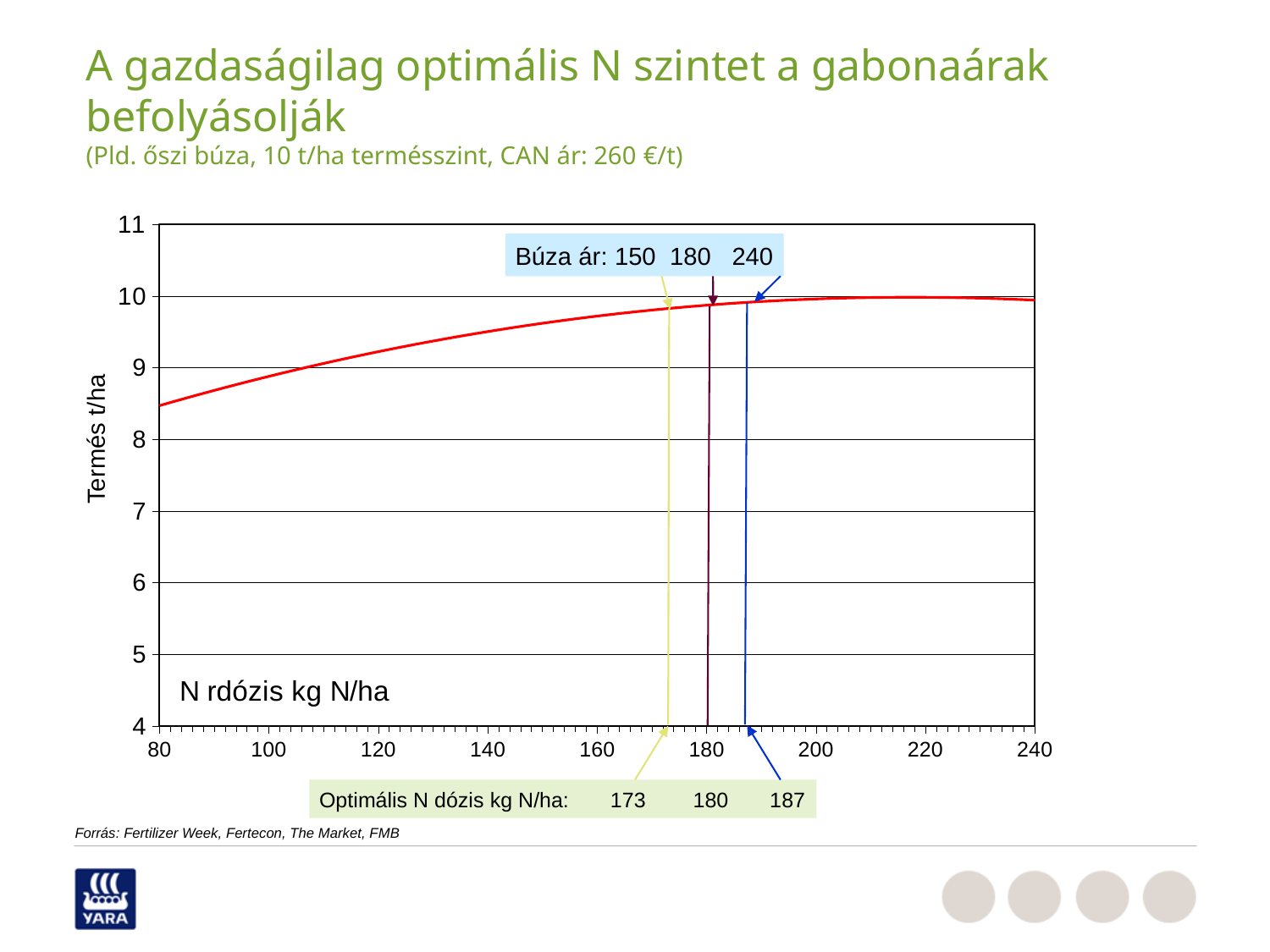
What is the difference between the optimal N dose at a wheat price of 240 and at a wheat price of 150? 14 What kind of chart is shown on the slide? line chart Is the yield (Termés t/ha) at an N dose of 200 kg N/ha greater or less than 9? greater According to the annotation, what is the optimal N dose (kg N/ha) at a wheat price of 180? 180 What is the label of the vertical axis of the chart? Termés t/ha According to the annotation, what is the optimal N dose (kg N/ha) at a wheat price of 150? 173 Does the yield curve rise or fall as the N dose increases from 80 to 200 kg N/ha? rise Is the yield (Termés t/ha) at an N dose of 80 kg N/ha greater or less than 9? less Which wheat price shown corresponds to the highest optimal N dose? 240 According to the annotation, what is the optimal N dose (kg N/ha) at a wheat price of 240? 187 What is the highest value shown on the horizontal axis of the chart? 240 Which wheat price shown corresponds to the lowest optimal N dose? 150